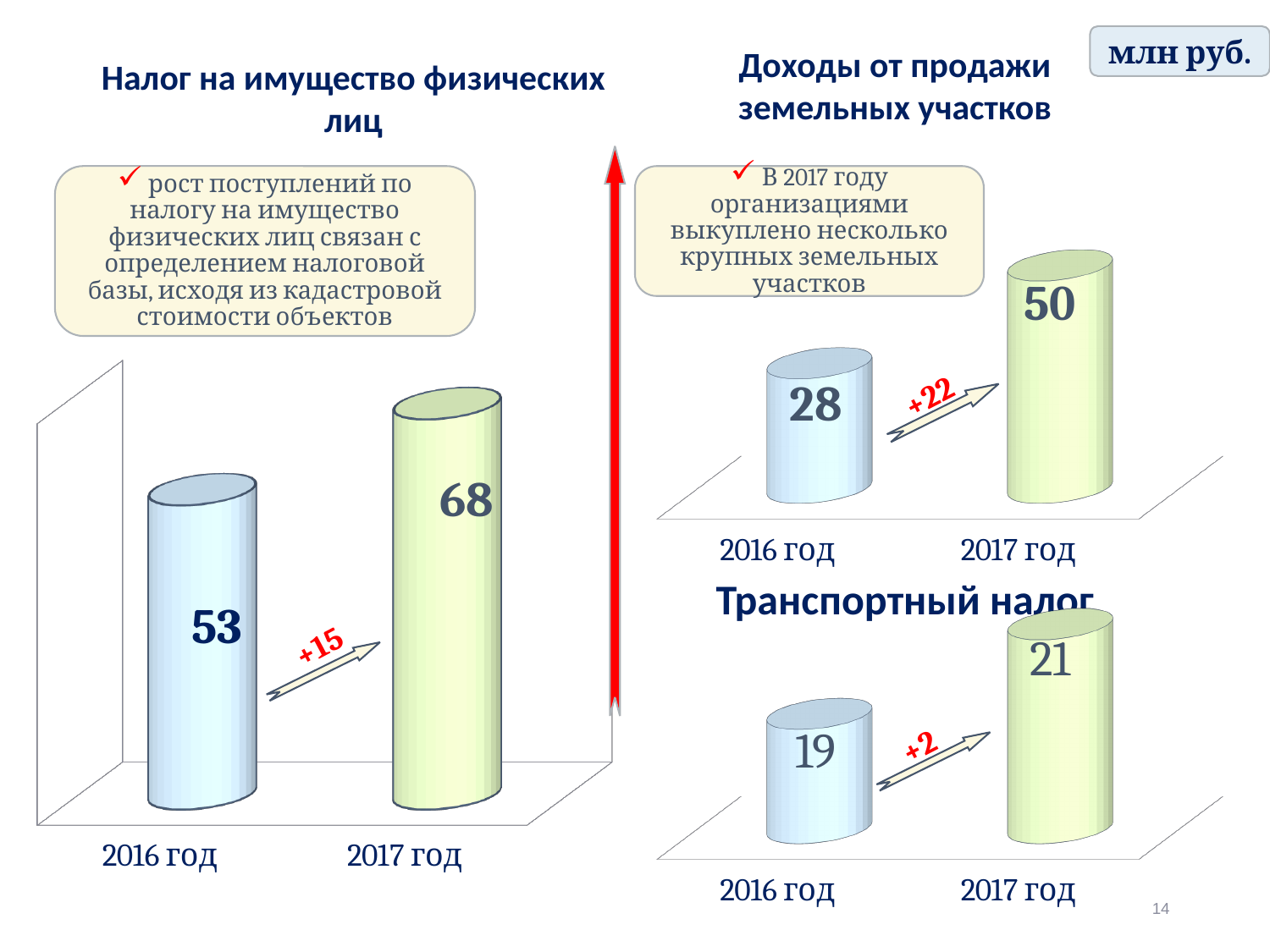
What unit of measurement is indicated for the charts on the slide? млн руб. In the chart 'Налог на имущество физических лиц', what is the value for 2017 год? 68 In the chart 'Транспортный налог', what is the value for 2016 год? 19 In the chart 'Налог на имущество физических лиц', do the values rise or fall from 2016 год to 2017 год? rise In the chart 'Налог на имущество физических лиц', what is the value for 2016 год? 53 In the chart 'Доходы от продажи земельных участков', by how much did the value increase from 2016 год to 2017 год? 22 In the chart 'Транспортный налог', which year has the higher value, 2016 год or 2017 год? 2017 год In the chart 'Доходы от продажи земельных участков', what is the value for 2017 год? 50 In the chart 'Транспортный налог', what is the value for 2017 год? 21 In the chart 'Налог на имущество физических лиц', what is the difference between the 2017 год and 2016 год values? 15 In the chart 'Доходы от продажи земельных участков', what is the value for 2016 год? 28 How many categories are shown in the chart 'Доходы от продажи земельных участков'? 2